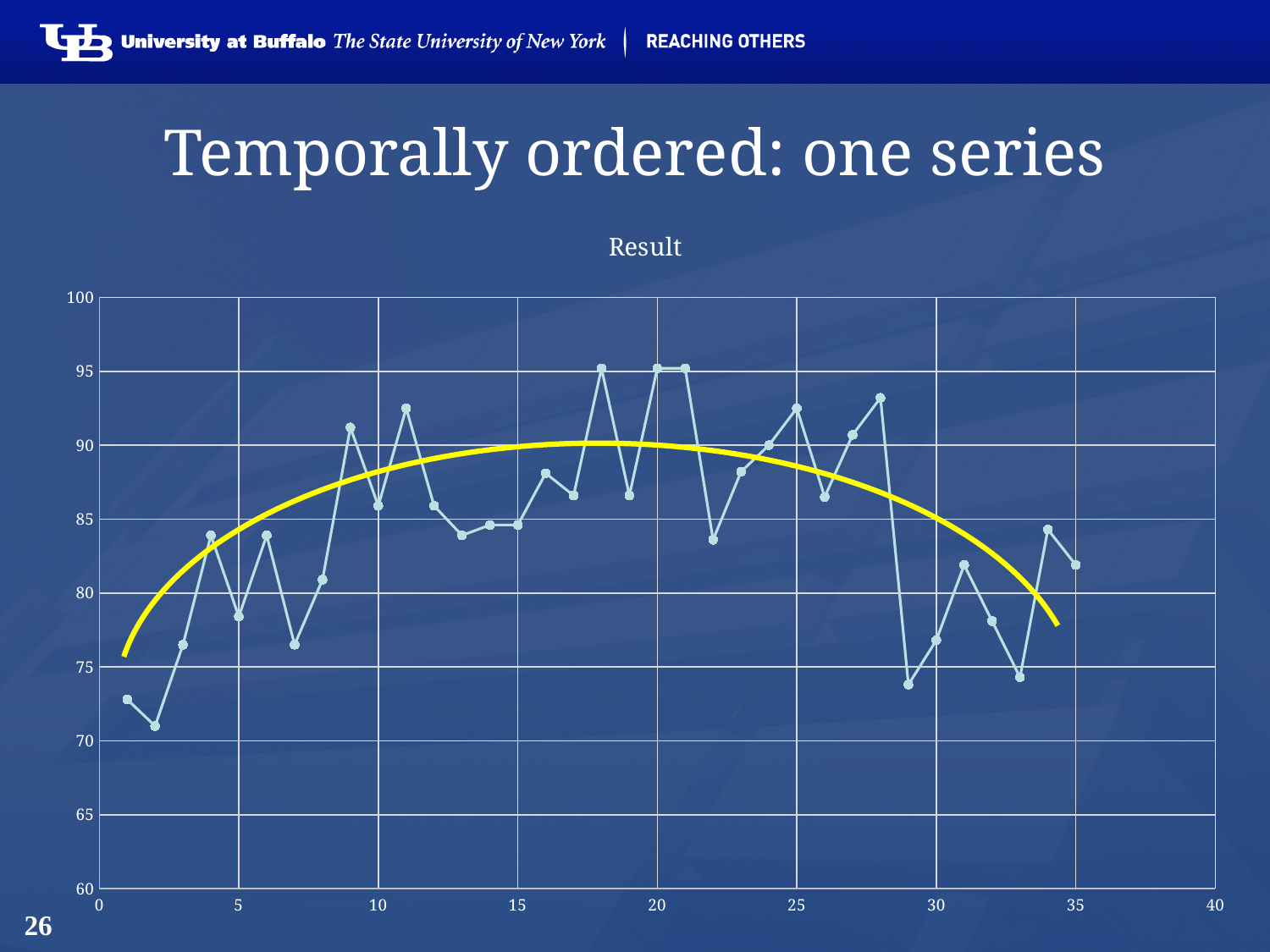
Is the value at x = 28 greater or less than 90? greater Is the value at x = 22 greater or less than 85? less At which x value is the lowest point on the line? 2 What is the title of the chart? Result What kind of chart is shown on the slide? line chart Is the value at x = 11 greater or less than 90? greater How many data points are plotted on the line? 35 Does the yellow fitted curve rise or fall between x = 30 and x = 34? fall What colour is the smooth fitted curve drawn over the data? yellow Which has the larger value, the point at x = 10 or the point at x = 11? x = 11